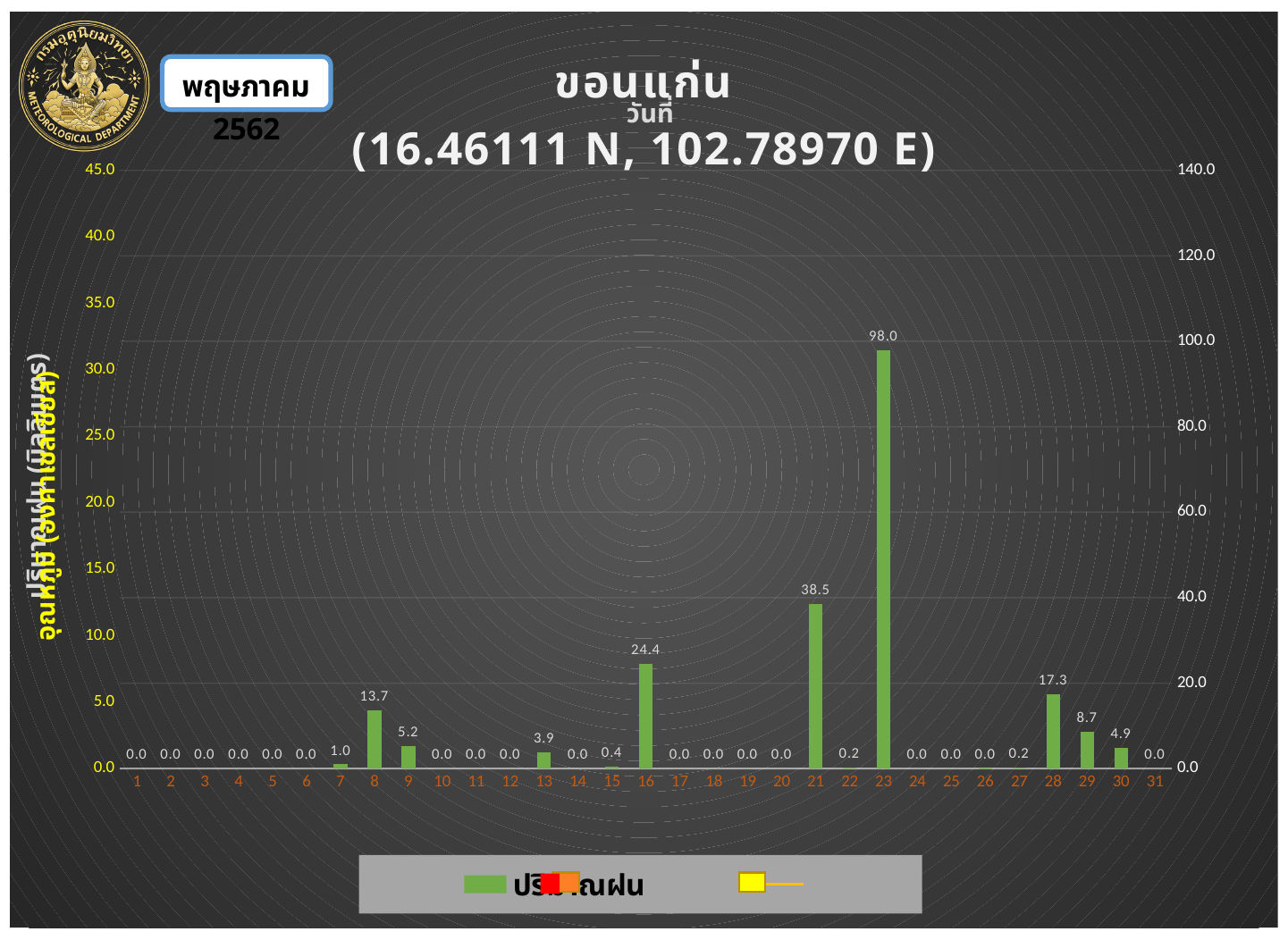
What is the rainfall value labelled for day 16? 24.4 What is the combined rainfall value for days 28, 29 and 30? 30.9 Which day has the highest rainfall value? 23 What is the rainfall value labelled for day 23? 98.0 What is the difference between the rainfall values for day 23 and day 21? 59.5 Which day has the larger rainfall value, day 8 or day 9? 8 What station name is shown in the chart title? ขอนแก่น What is the rainfall value labelled for day 21? 38.5 Is the rainfall value for day 23 greater or less than 80.0 on the right-hand axis? greater How many days are shown along the x axis? 31 What kind of chart is used to show the rainfall values? bar chart What is the rainfall value labelled for day 28? 17.3